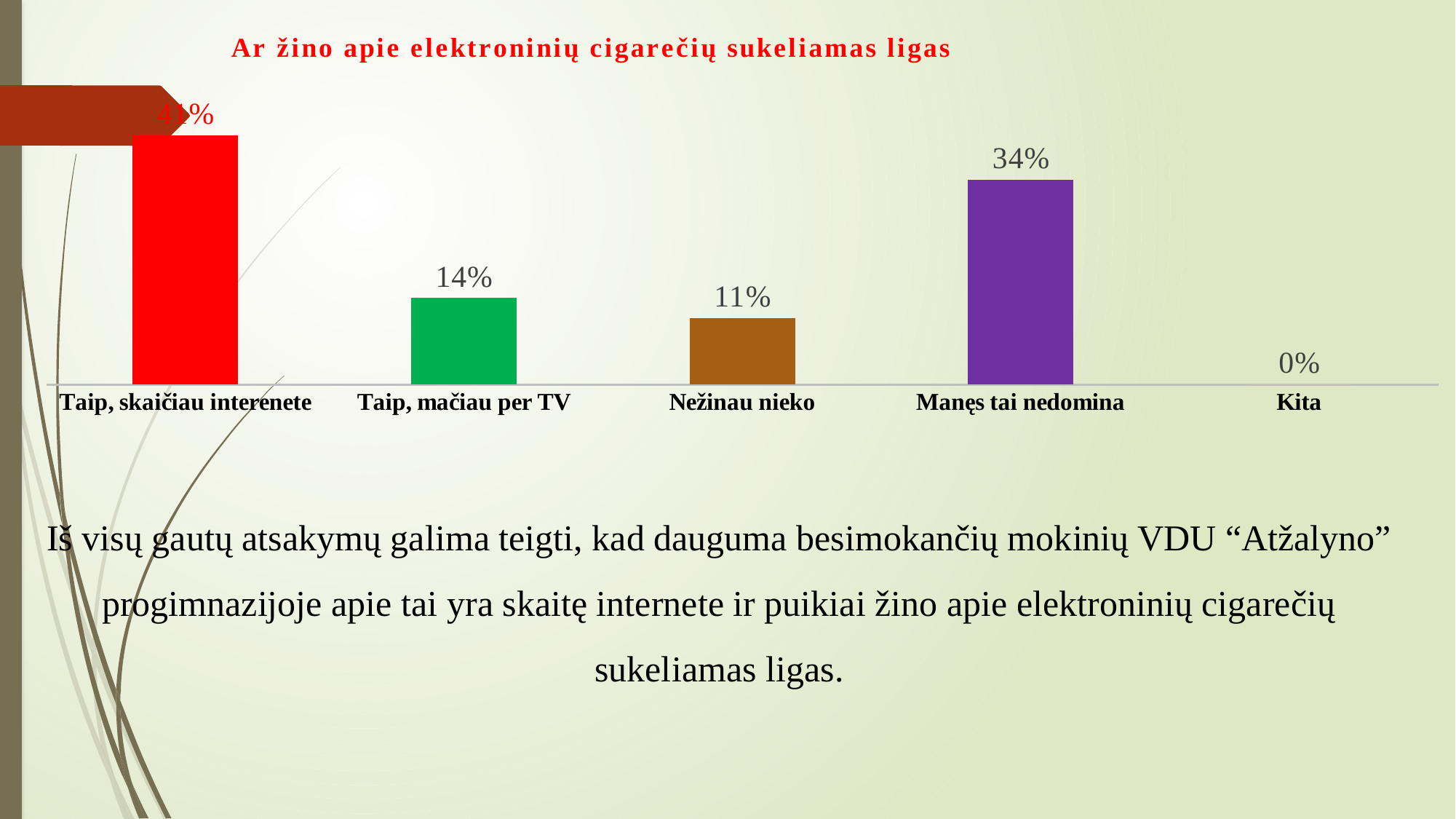
How many categories are shown in the chart? 5 What is the difference between "Manęs tai nedomina" and "Taip, mačiau per TV"? 20% Which category has the lowest value? Kita What is the difference between "Taip, mačiau per TV" and "Nežinau nieko"? 3% Which category has the highest value? Taip, skaičiau interenete What is the value for "Taip, mačiau per TV"? 14% What is the title of the chart? Ar žino apie elektroninių cigarečių sukeliamas ligas What is the value for "Manęs tai nedomina"? 34% What is the value for "Nežinau nieko"? 11% What is the value for "Kita"? 0% What kind of chart is shown on the slide? Bar chart Which is larger, "Manęs tai nedomina" or "Nežinau nieko"? Manęs tai nedomina